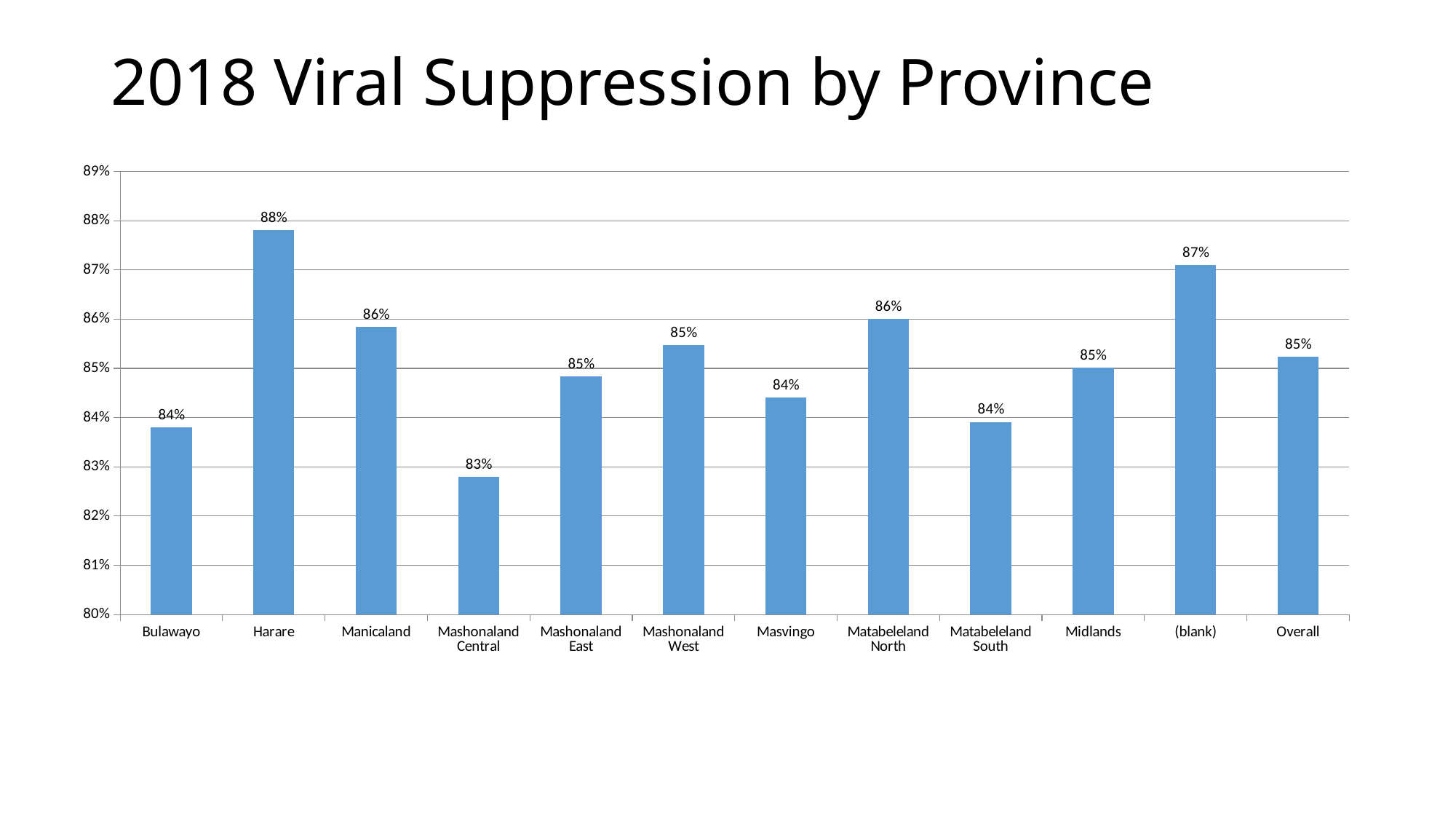
What is the value shown for Matabeleland North? 86% Is the value for Harare greater or less than 87%? greater Is the value for Mashonaland Central greater or less than 84%? less Which is larger, the value for Harare or the value for Bulawayo? Harare What is the value shown for the Overall bar? 85% Which province has the lowest viral suppression? Mashonaland Central What is the viral suppression value for Mashonaland Central? 83% Which province has the highest viral suppression? Harare What is the viral suppression value for Harare? 88% What is the difference between the labelled values for Harare and Mashonaland Central? 5% How many bars are shown in the chart? 12 What type of chart is shown on the slide? Bar chart